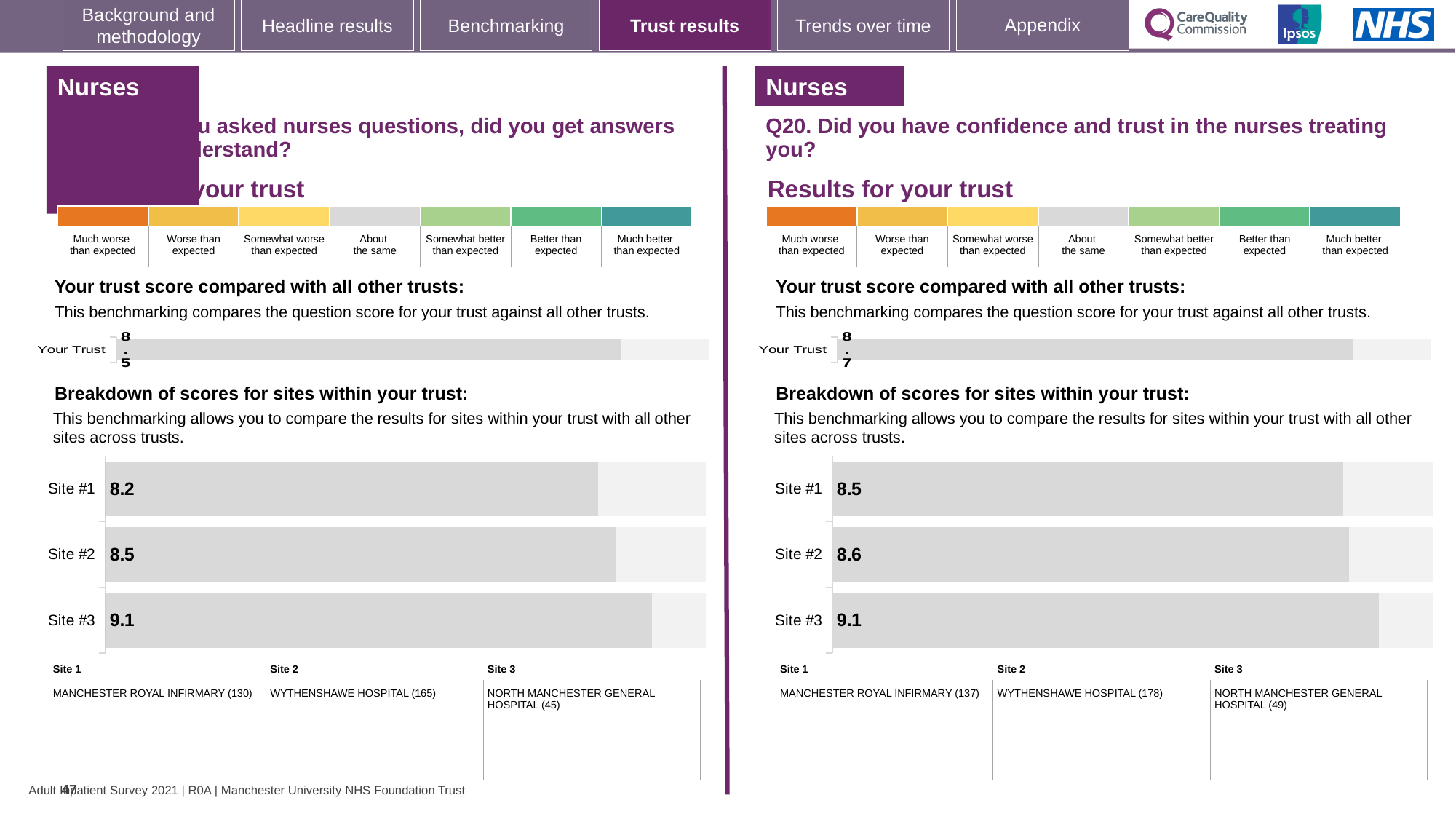
What type of chart is used for the site breakdown on the right-hand side of the slide? Bar chart In the Q20 (confidence and trust in nurses) site breakdown chart, what is the score for Site #2? 8.6 How many sites are shown in the left-hand site breakdown chart? 3 In the Q20 (confidence and trust in nurses) site breakdown chart, which site has the highest score? Site #3 In the left-hand site breakdown chart, what is the score for Site #3? 9.1 In the left-hand site breakdown chart, what is the difference between the scores for Site #3 and Site #1? 0.9 In the left-hand site breakdown chart, which site has the highest score? Site #3 In the left-hand site breakdown chart, which site has the lowest score? Site #1 In the Q20 (confidence and trust in nurses) site breakdown chart, what is the score for Site #1? 8.5 In the Q20 (confidence and trust in nurses) site breakdown chart, what is the difference between the scores for Site #3 and Site #2? 0.5 In the left-hand site breakdown chart, what is the score for Site #1? 8.2 What is the 'Your Trust' score shown in the Q20 (confidence and trust in nurses) trust comparison chart? 8.7